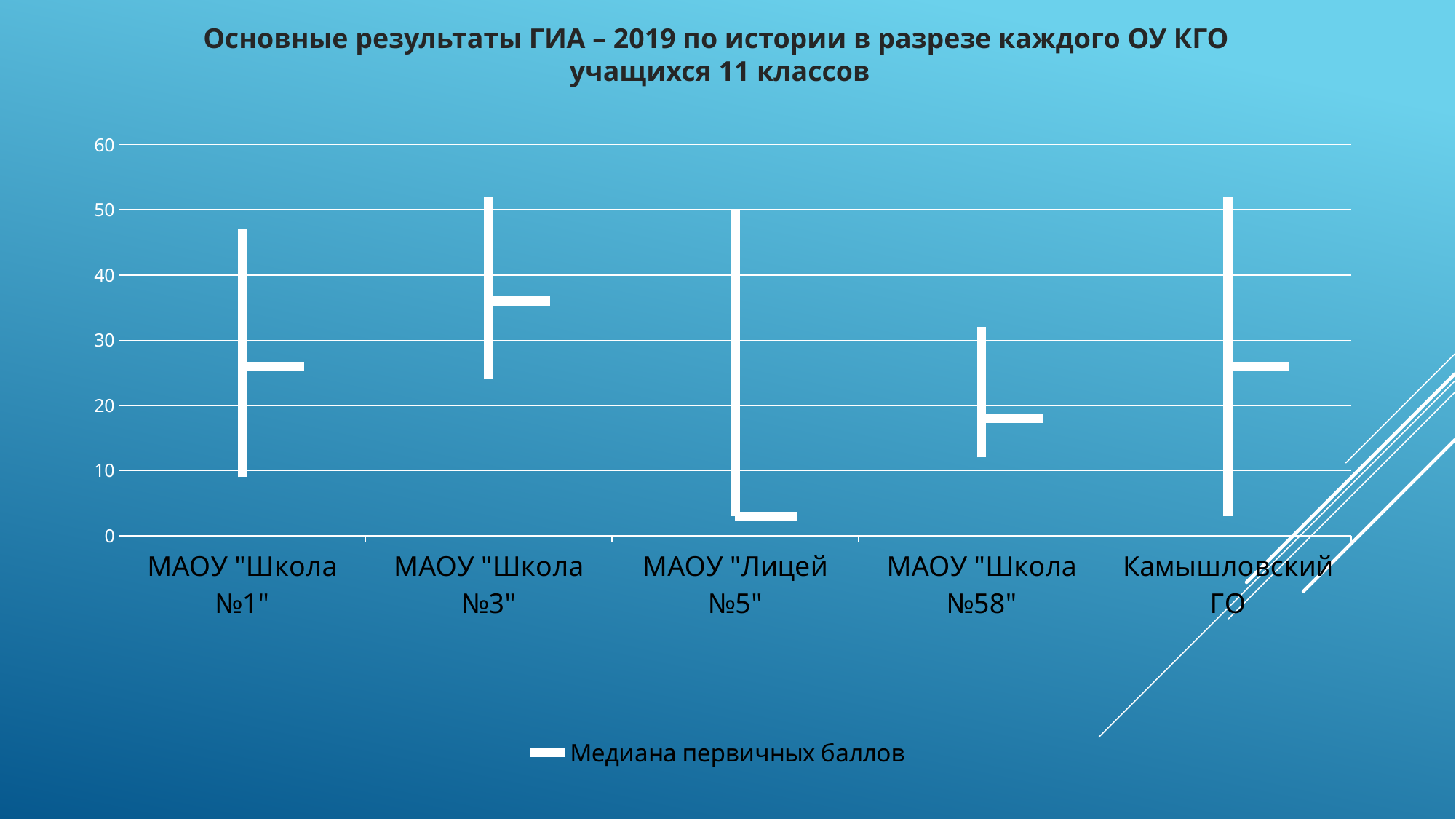
Is the median of primary scores for МАОУ "Школа №3" greater or less than 30? greater Which school has the lowest median of primary scores (Медиана первичных баллов)? МАОУ "Лицей №5" How many series does the chart legend list? 1 What is the name of the series shown in the chart legend? Медиана первичных баллов Is the median of primary scores for МАОУ "Школа №1" greater or less than 20? greater Which has the larger median of primary scores: МАОУ "Школа №3" or МАОУ "Школа №58"? МАОУ "Школа №3" What is the title of the chart? Основные результаты ГИА – 2019 по истории в разрезе каждого ОУ КГО учащихся 11 классов Which school has the highest median of primary scores (Медиана первичных баллов)? МАОУ "Школа №3" Is the median of primary scores for МАОУ "Школа №58" greater or less than 20? less How many schools (categories) are shown on the x axis of the chart? 5